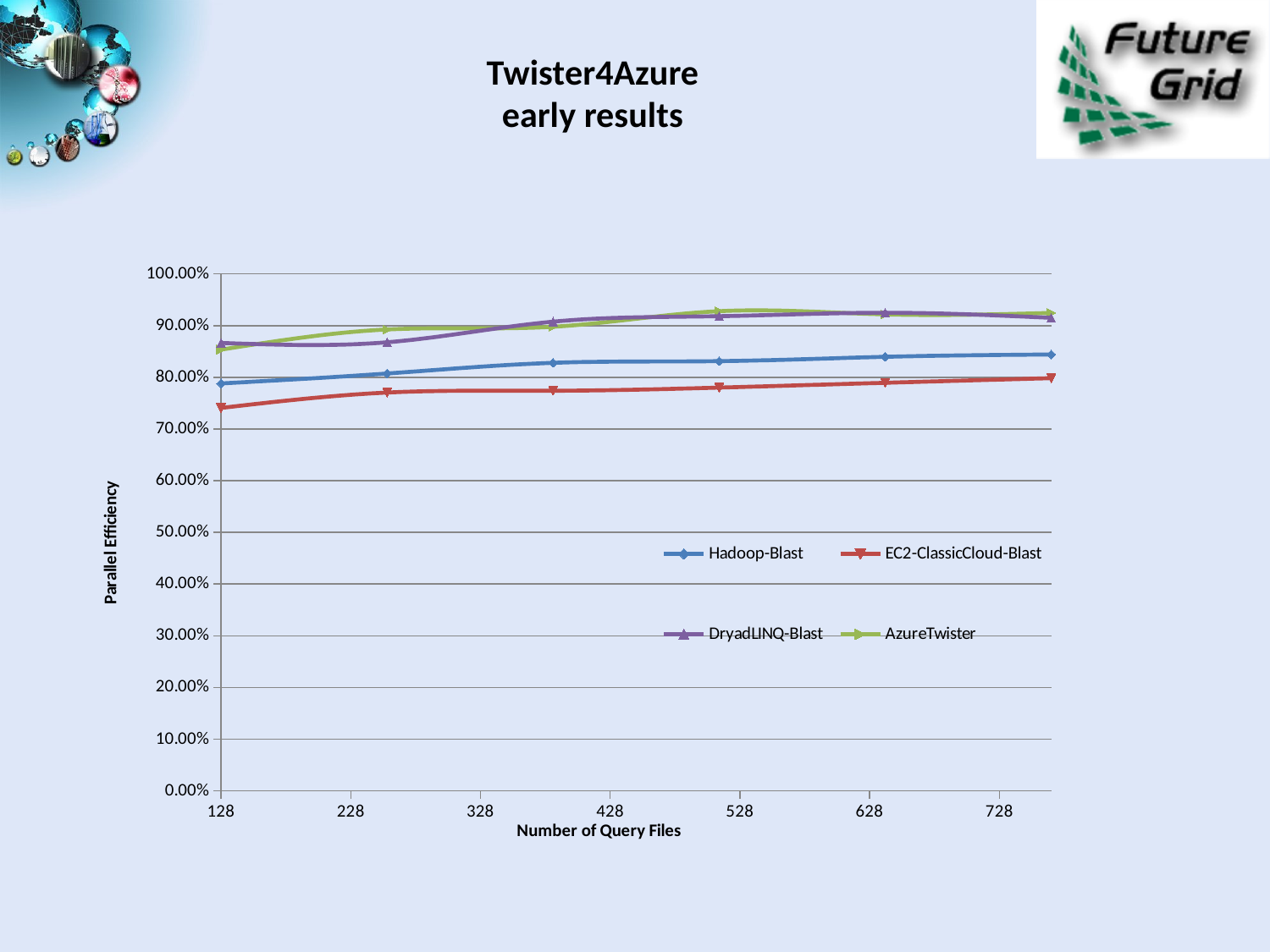
Is the value for EC2-ClassicCloud-Blast at 128 query files greater or less than 80.00%? less Is the value for Hadoop-Blast at 128 query files greater or less than 70.00%? greater Which series has the lowest parallel efficiency at 128 query files? EC2-ClassicCloud-Blast Does the EC2-ClassicCloud-Blast line rise or fall as the number of query files increases? rise What is the title of the x axis? Number of Query Files Is the value for AzureTwister at its rightmost point greater or less than 90.00%? greater What kind of chart is shown on the slide? line chart How many data points does each series have? 6 How many series does the legend list? 4 At 128 query files, which is larger: DryadLINQ-Blast or Hadoop-Blast? DryadLINQ-Blast At 128 query files, which is larger: Hadoop-Blast or EC2-ClassicCloud-Blast? Hadoop-Blast